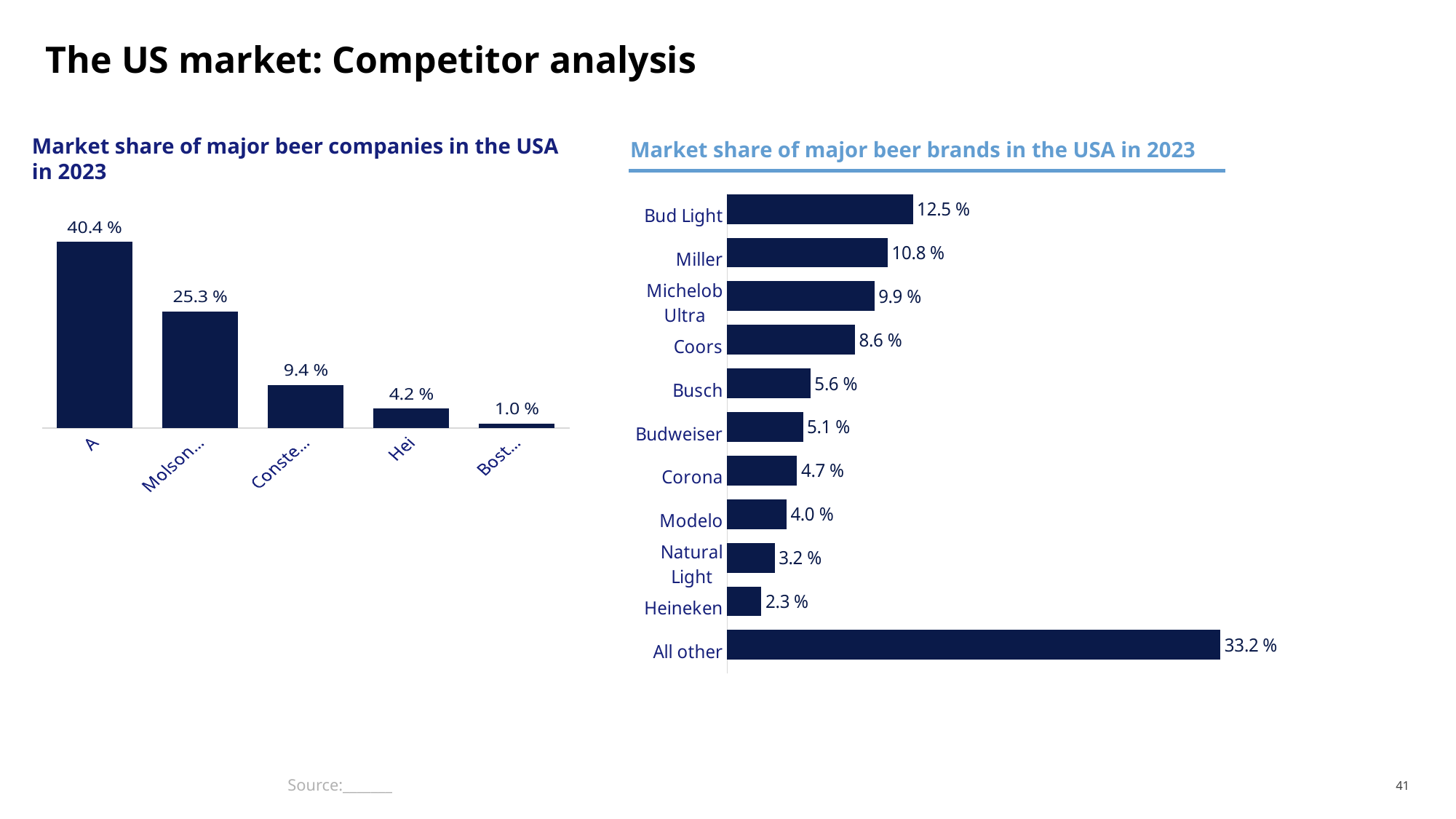
In the chart 'Market share of major beer brands in the USA in 2023', which named brand has the smallest market share? Heineken In the chart 'Market share of major beer companies in the USA in 2023', what is the value of the smallest bar? 1.0 % How many categories are shown in the chart 'Market share of major beer brands in the USA in 2023'? 11 How many bars are shown in the chart 'Market share of major beer companies in the USA in 2023'? 5 What kind of chart is 'Market share of major beer brands in the USA in 2023'? Bar chart In the chart 'Market share of major beer brands in the USA in 2023', which category has the largest bar? All other In the chart 'Market share of major beer brands in the USA in 2023', what is the market share of Coors? 8.6 % In the chart 'Market share of major beer brands in the USA in 2023', which has a larger market share, Busch or Budweiser? Busch In the chart 'Market share of major beer companies in the USA in 2023', what is the value of the tallest bar? 40.4 % In the chart 'Market share of major beer brands in the USA in 2023', what is the market share of Heineken? 2.3 % In the chart 'Market share of major beer brands in the USA in 2023', what is the difference between the market shares of Bud Light and Miller? 1.7 % In the chart 'Market share of major beer brands in the USA in 2023', what is the market share of Bud Light? 12.5 %